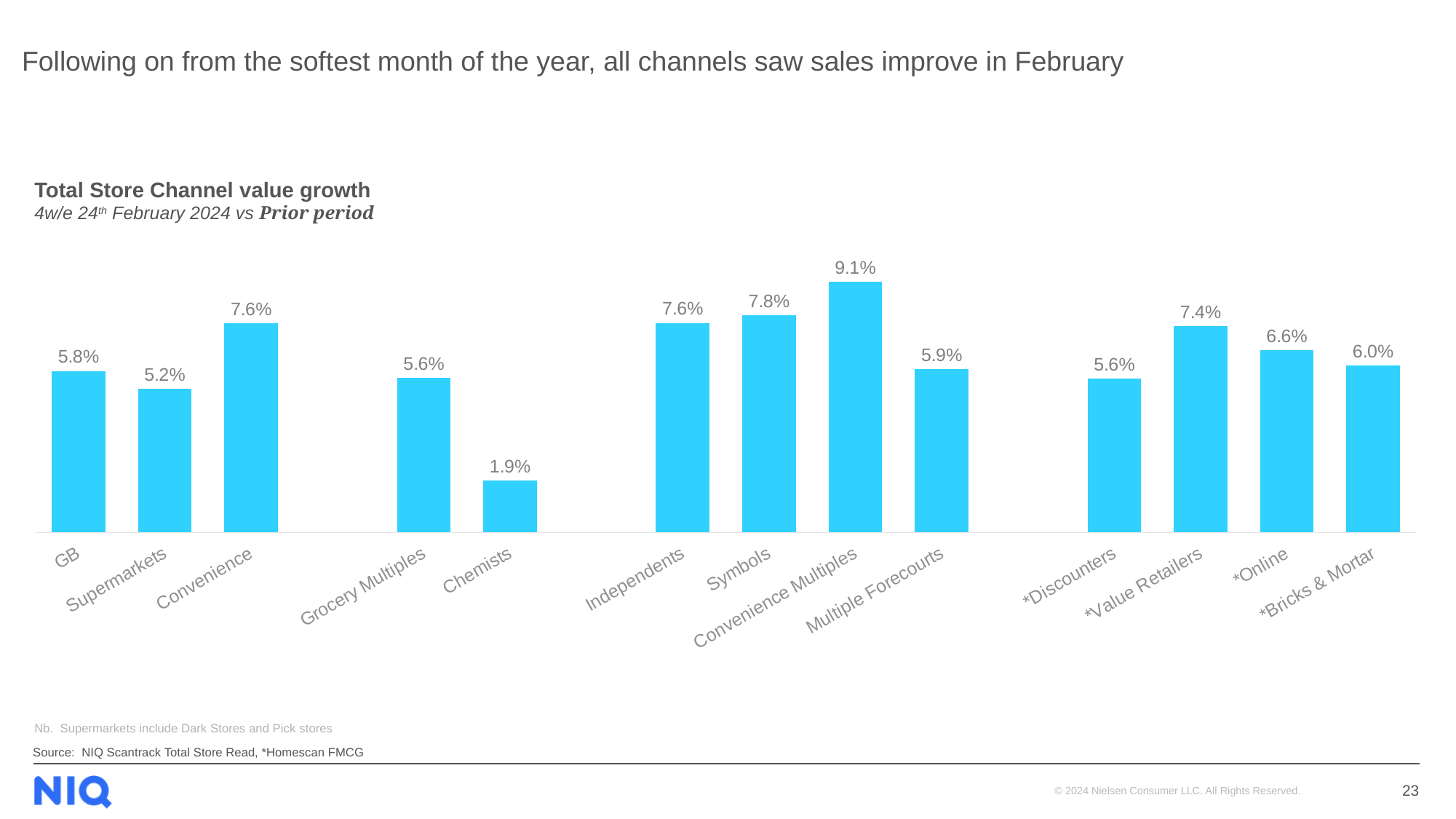
What is the difference between the value growth for Symbols and Independents? 0.2% What is the value growth for Supermarkets? 5.2% Which channel has the highest value growth? Convenience Multiples What is the difference between the value growth for Convenience Multiples and Chemists? 7.2% What is the value growth for Chemists? 1.9% How many channels are plotted on the chart? 13 What kind of chart is shown on the slide? Bar chart Which channel has the lowest value growth? Chemists What is the title of the chart? Total Store Channel value growth What is the value growth for *Online? 6.6% What is the value growth for Convenience Multiples? 9.1% Which has higher value growth, *Value Retailers or *Bricks & Mortar? *Value Retailers